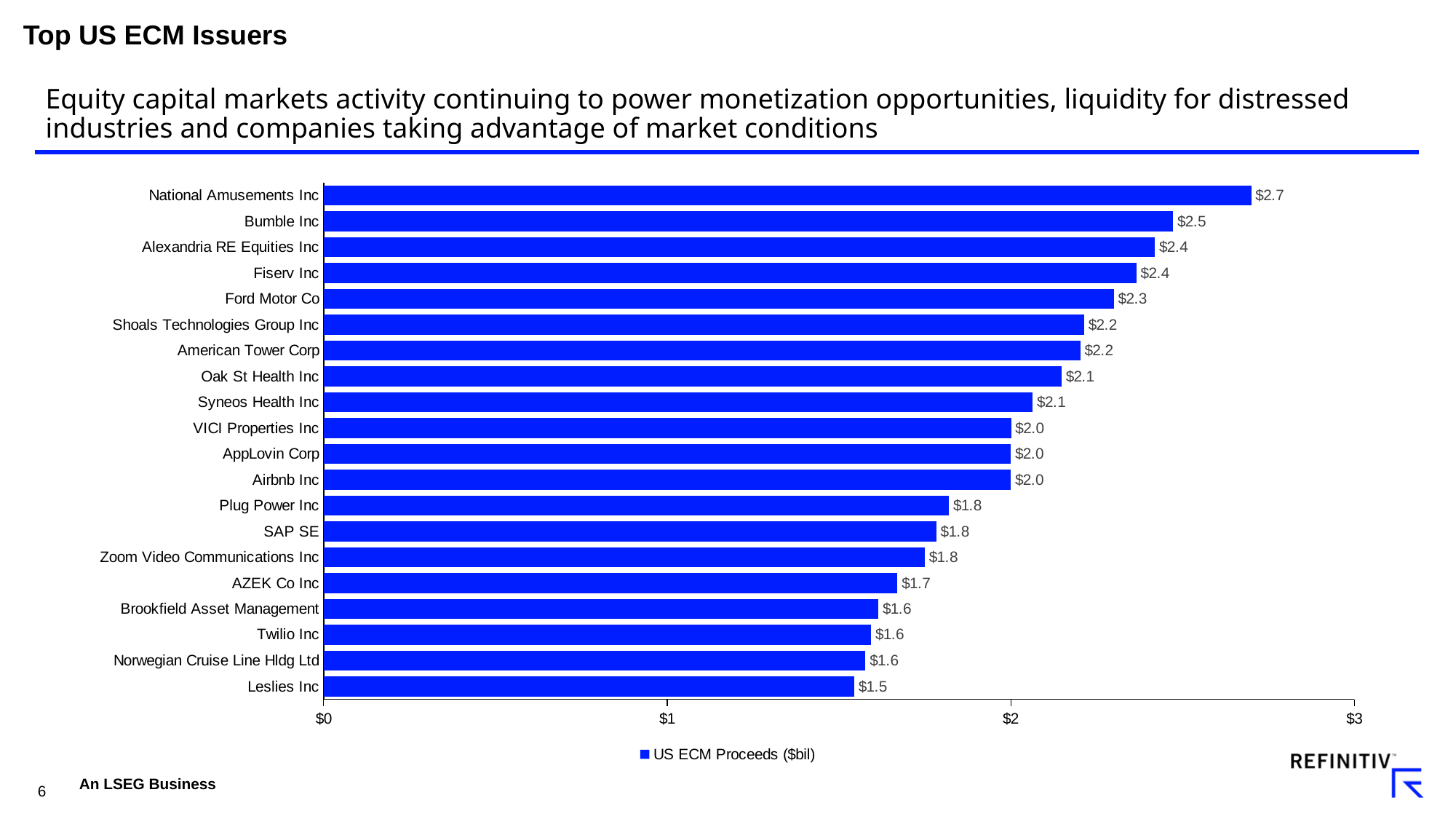
Which has larger US ECM proceeds, Ford Motor Co or Plug Power Inc? Ford Motor Co Is the value for Airbnb Inc greater or less than $1? greater What is the US ECM proceeds value for Leslies Inc? $1.5 Which issuer has the highest US ECM proceeds? National Amusements Inc How many series does the legend list? 1 How many issuers are shown in the chart? 20 What is the US ECM proceeds value for National Amusements Inc? $2.7 What is the US ECM proceeds value for Ford Motor Co? $2.3 What is the legend entry for the series shown in the chart? US ECM Proceeds ($bil) What is the difference between the US ECM proceeds of National Amusements Inc and Bumble Inc? $0.2 Which issuer has the lowest US ECM proceeds? Leslies Inc What kind of chart is shown on the slide? Bar chart